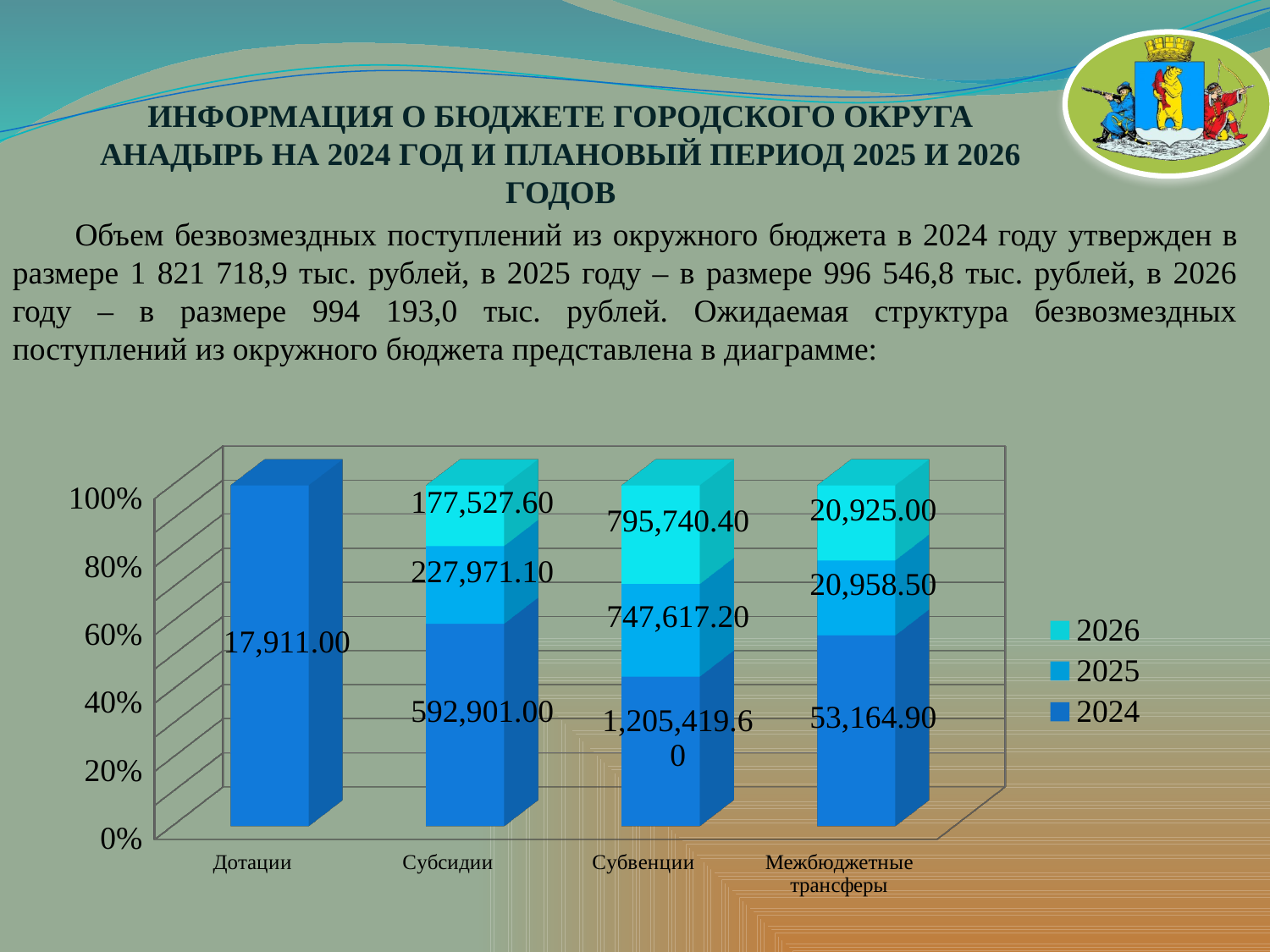
What kind of chart is shown on the slide? Stacked bar chart What is the difference between the 2024 and 2025 values in the Субсидии category? 364,929.90 How many series does the legend list? 3 What is the value for 2025 in the Межбюджетные трансферы category? 20,958.50 What is the value shown for the Дотации category? 17,911.00 Which category has the highest value for the 2024 series? Субвенции In the Субвенции category, which is larger: the 2025 value or the 2026 value? 2026 What is the value for 2026 in the Субвенции category? 795,740.40 Which category has the lowest value for the 2024 series? Дотации What is the value for 2024 in the Субсидии category? 592,901.00 What is the difference between the 2026 and 2025 values in the Субвенции category? 48,123.20 How many categories are shown on the x axis of the chart? 4